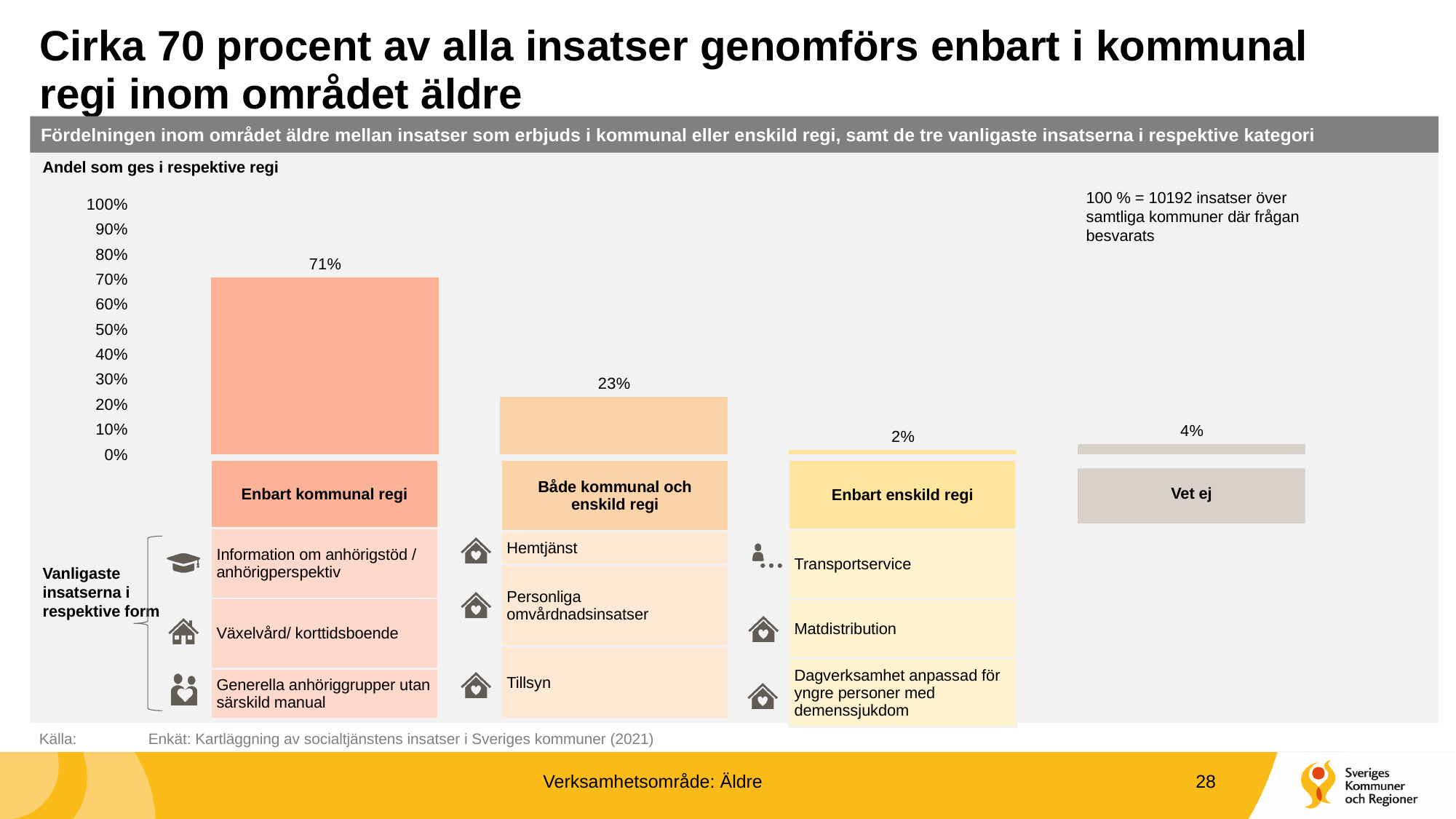
What is the difference in percentage points between 'Enbart kommunal regi' and 'Både kommunal och enskild regi'? 48 percentage points What share is shown for 'Vet ej'? 4% What share of insatser is given in 'Enbart enskild regi'? 2% What kind of chart is shown on the slide? Bar chart What share of insatser is given in 'Både kommunal och enskild regi'? 23% Which category has the lowest share? Enbart enskild regi Which is larger, the share for 'Vet ej' or the share for 'Enbart enskild regi'? Vet ej Is the value for 'Både kommunal och enskild regi' greater or less than 30%? less What share of insatser is given in 'Enbart kommunal regi'? 71% How many categories are shown in the bar chart? 4 According to the note on the chart, how many insatser does 100% correspond to? 10192 insatser Which category has the highest share? Enbart kommunal regi